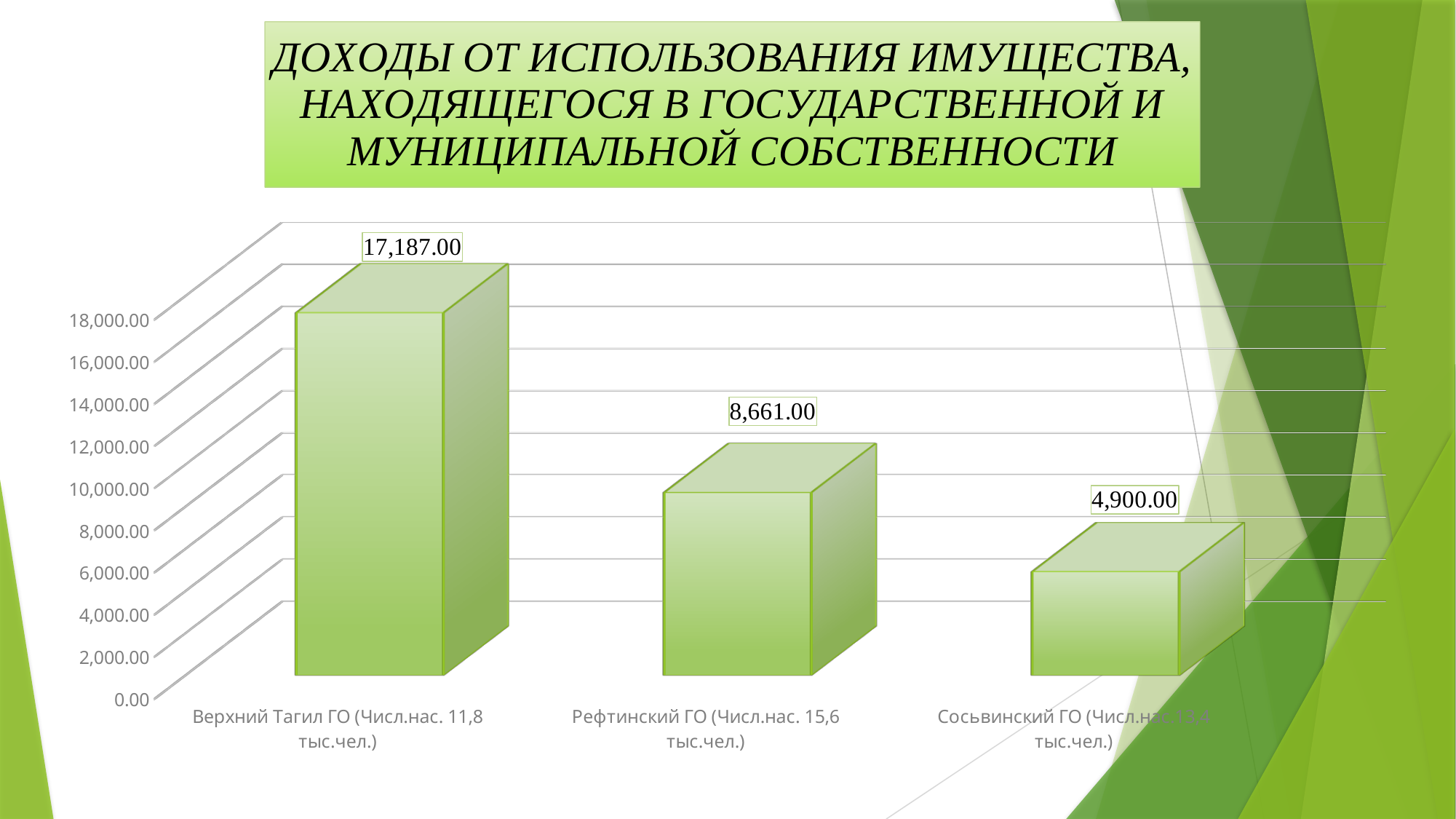
What is the value for Верхний Тагил ГО? 17,187.00 What is the value for Рефтинский ГО? 8,661.00 What is the difference between the values for Рефтинский ГО and Сосьвинский ГО? 3,761.00 Do the values rise or fall from left to right across the categories? fall How many categories are shown in the chart? 3 Which is larger, the value for Рефтинский ГО or the value for Сосьвинский ГО? Рефтинский ГО What is the difference between the values for Верхний Тагил ГО and Рефтинский ГО? 8,526.00 Is the value for Рефтинский ГО greater or less than 10,000.00? less What is the value for Сосьвинский ГО? 4,900.00 Which category has the lowest value? Сосьвинский ГО Which category has the highest value? Верхний Тагил ГО What kind of chart is shown on the slide? bar chart